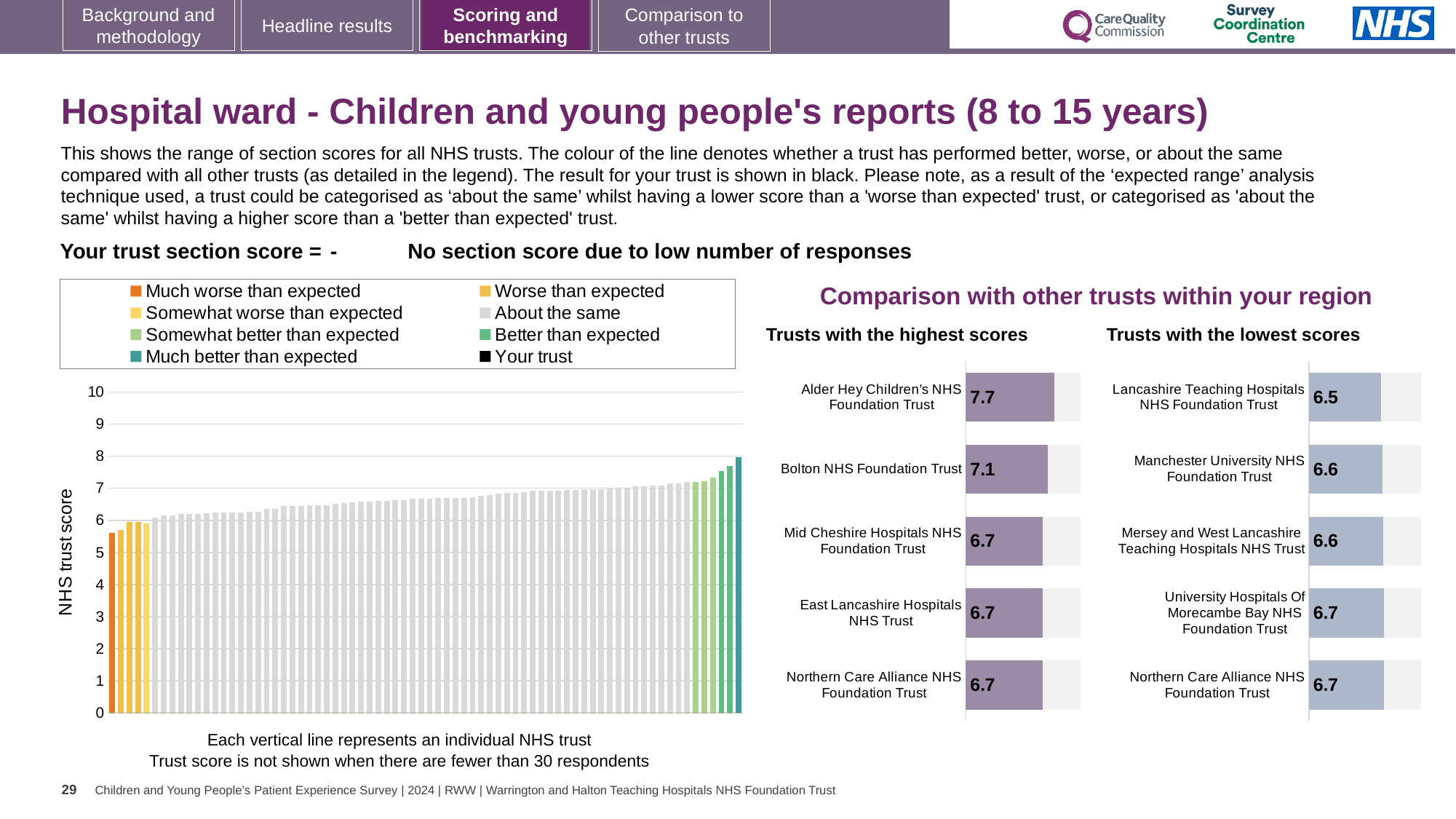
In the 'Trusts with the highest scores' chart, what is the difference between the scores of Alder Hey Children's NHS Foundation Trust and Bolton NHS Foundation Trust? 0.6 In the large 'NHS trust score' chart on the left, is the value of the lowest (leftmost) bar greater or less than 5? greater In the 'Trusts with the lowest scores' chart, what is the score for University Hospitals Of Morecambe Bay NHS Foundation Trust? 6.7 In the 'Trusts with the lowest scores' chart, which trust has the lowest score? Lancashire Teaching Hospitals NHS Foundation Trust How many entries does the legend above the large 'NHS trust score' chart list? 8 In the 'Trusts with the lowest scores' chart, which has the larger score: Lancashire Teaching Hospitals NHS Foundation Trust or Manchester University NHS Foundation Trust? Manchester University NHS Foundation Trust In the 'Trusts with the highest scores' chart, which trust has the highest score? Alder Hey Children's NHS Foundation Trust How many trusts are shown in the 'Trusts with the highest scores' chart? 5 In the 'Trusts with the highest scores' chart, what is the score for Bolton NHS Foundation Trust? 7.1 In the large 'NHS trust score' chart on the left, do the bar values rise or fall from left to right? rise In the 'Trusts with the highest scores' chart, what is the score for Alder Hey Children's NHS Foundation Trust? 7.7 In the 'Trusts with the lowest scores' chart, what is the score for Lancashire Teaching Hospitals NHS Foundation Trust? 6.5